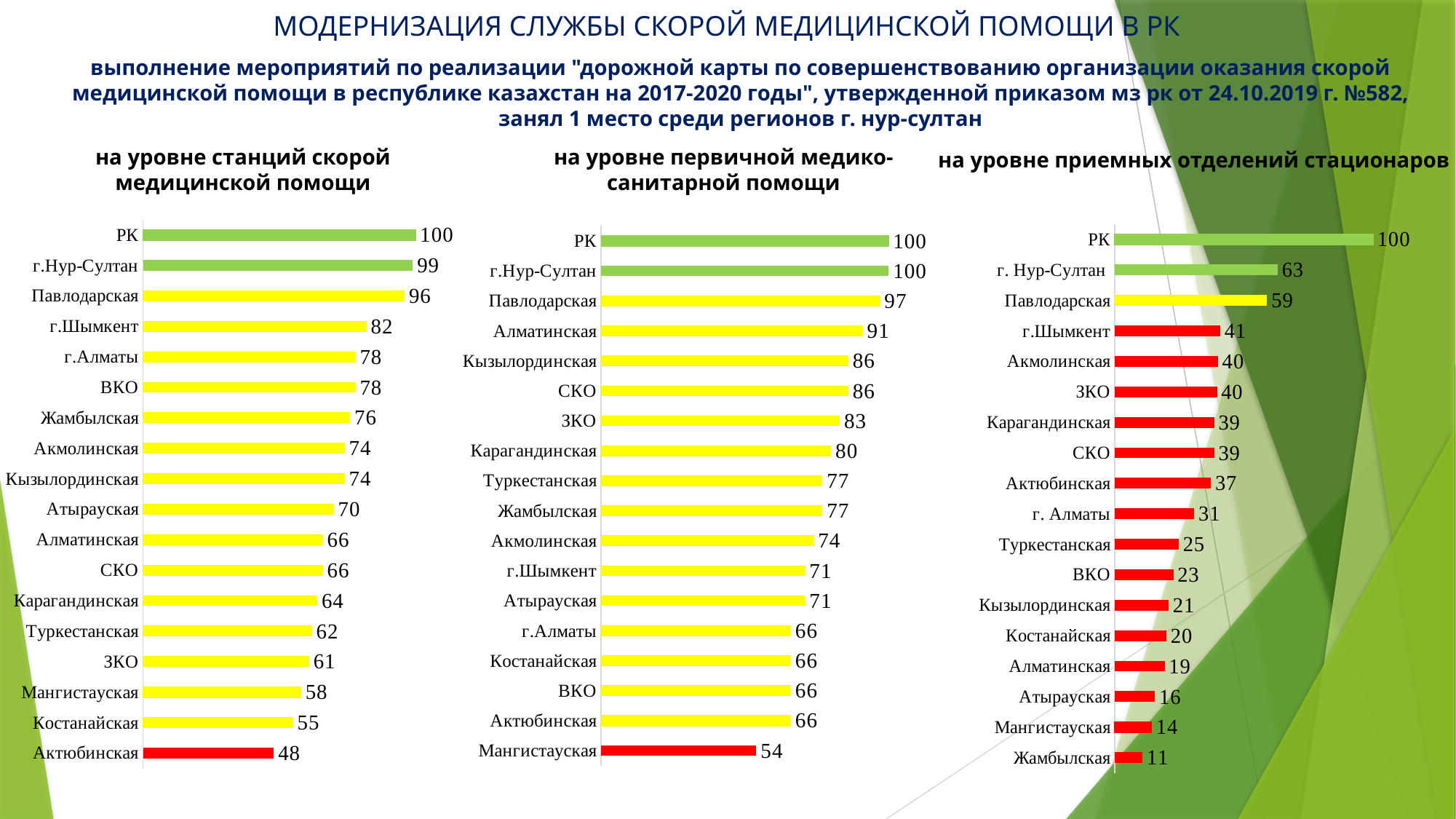
In the right chart (на уровне приемных отделений стационаров), what is the difference between Павлодарская and г.Шымкент? 18 In the middle chart (на уровне первичной медико-санитарной помощи), what colour is the bar for Мангистауская? Red In the left chart (на уровне станций скорой медицинской помощи), what is the value for Павлодарская? 96 In the left chart (на уровне станций скорой медицинской помощи), what is the difference between г.Нур-Султан and Актюбинская? 51 In the right chart (на уровне приемных отделений стационаров), what is the value for г. Нур-Султан? 63 In the right chart (на уровне приемных отделений стационаров), which region has the lowest value? Жамбылская In the left chart (на уровне станций скорой медицинской помощи), which region has the lowest value? Актюбинская In the middle chart (на уровне первичной медико-санитарной помощи), what is the value for Алматинская? 91 In the middle chart (на уровне первичной медико-санитарной помощи), which region has the lowest value? Мангистауская In the middle chart (на уровне первичной медико-санитарной помощи), which is larger: the value for ЗКО or the value for Акмолинская? ЗКО How many categories are plotted in the right chart (на уровне приемных отделений стационаров)? 18 What type of chart is the left chart (на уровне станций скорой медицинской помощи)? Bar chart